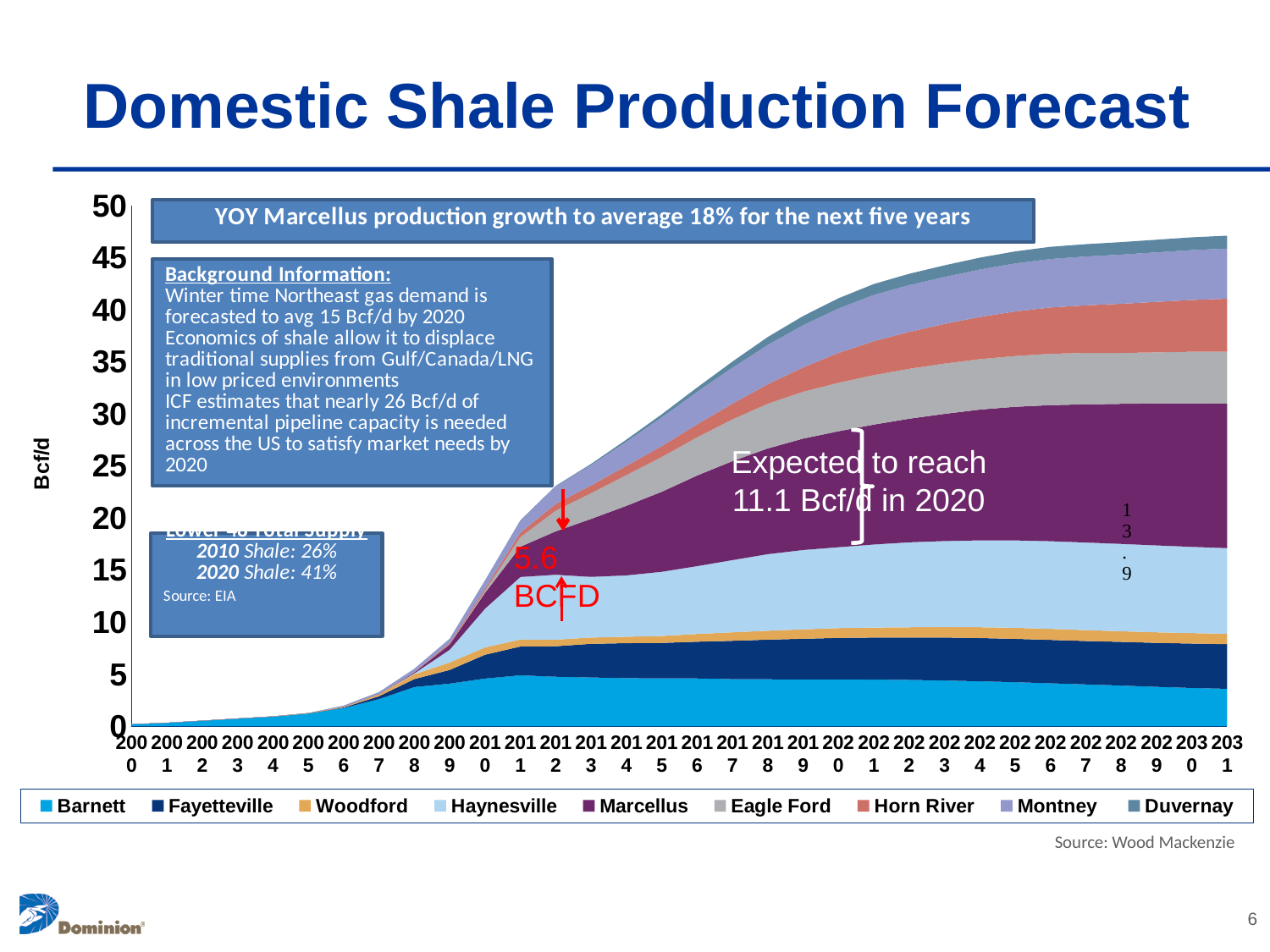
What source is cited below the chart? Wood Mackenzie Does total shale production rise or fall from 2000 to 2031 along the x axis? Rise According to the annotation on the chart, what is Marcellus production expected to reach in 2020? 11.1 Bcf/d Which series occupies the largest band of the stack in 2031, Marcellus or Haynesville? Marcellus How many years are plotted along the x axis of the chart? 32 How many series does the legend list? 9 What Marcellus production value is marked by the red arrows on the chart around 2012? 5.6 BCF/D Is the total stacked production in 2031 greater or less than 45 Bcf/d? greater Is the total stacked production in 2020 greater or less than 35 Bcf/d? greater What kind of chart is shown on the slide? Stacked area chart What is the label on the vertical axis of the chart? Bcf/d